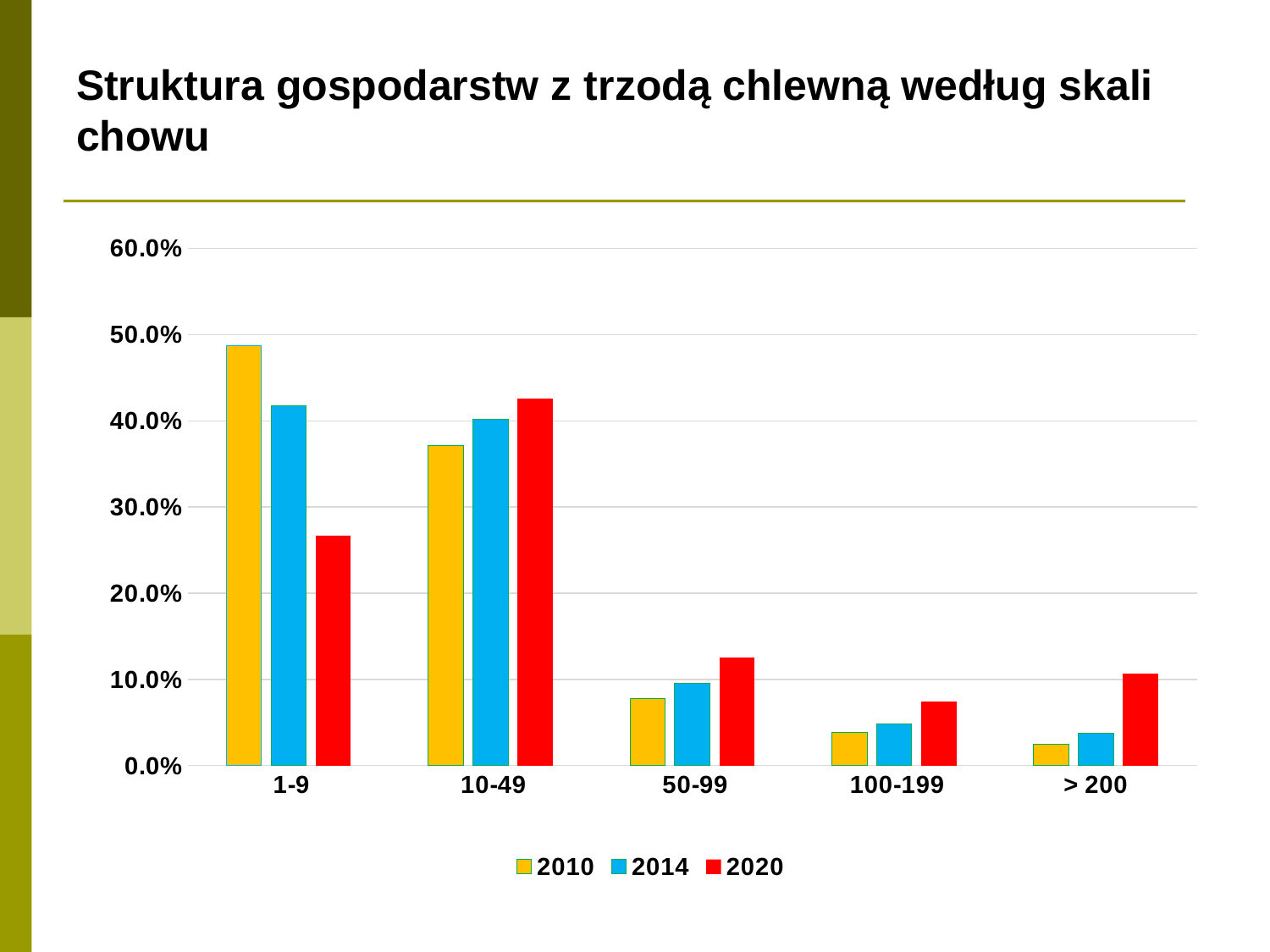
Which category has the highest value for the 2010 series? 1-9 Is the 2010 value for the 1-9 category greater or less than 40.0%? greater How many series does the legend list? 3 Which category has the highest value for the 2020 series? 10-49 Do the values of the 2010 series rise or fall moving from the 1-9 category to the > 200 category? fall What kind of chart is shown on the slide? bar chart For the 1-9 category, which series has the larger value, 2014 or 2020? 2014 How many categories are shown on the x axis? 5 What are the three entries listed in the legend? 2010, 2014, 2020 Is the 2020 value for the 1-9 category greater or less than 30.0%? less Which category has the lowest value for the 2010 series? > 200 For the > 200 category, which series has the larger value, 2010 or 2020? 2020